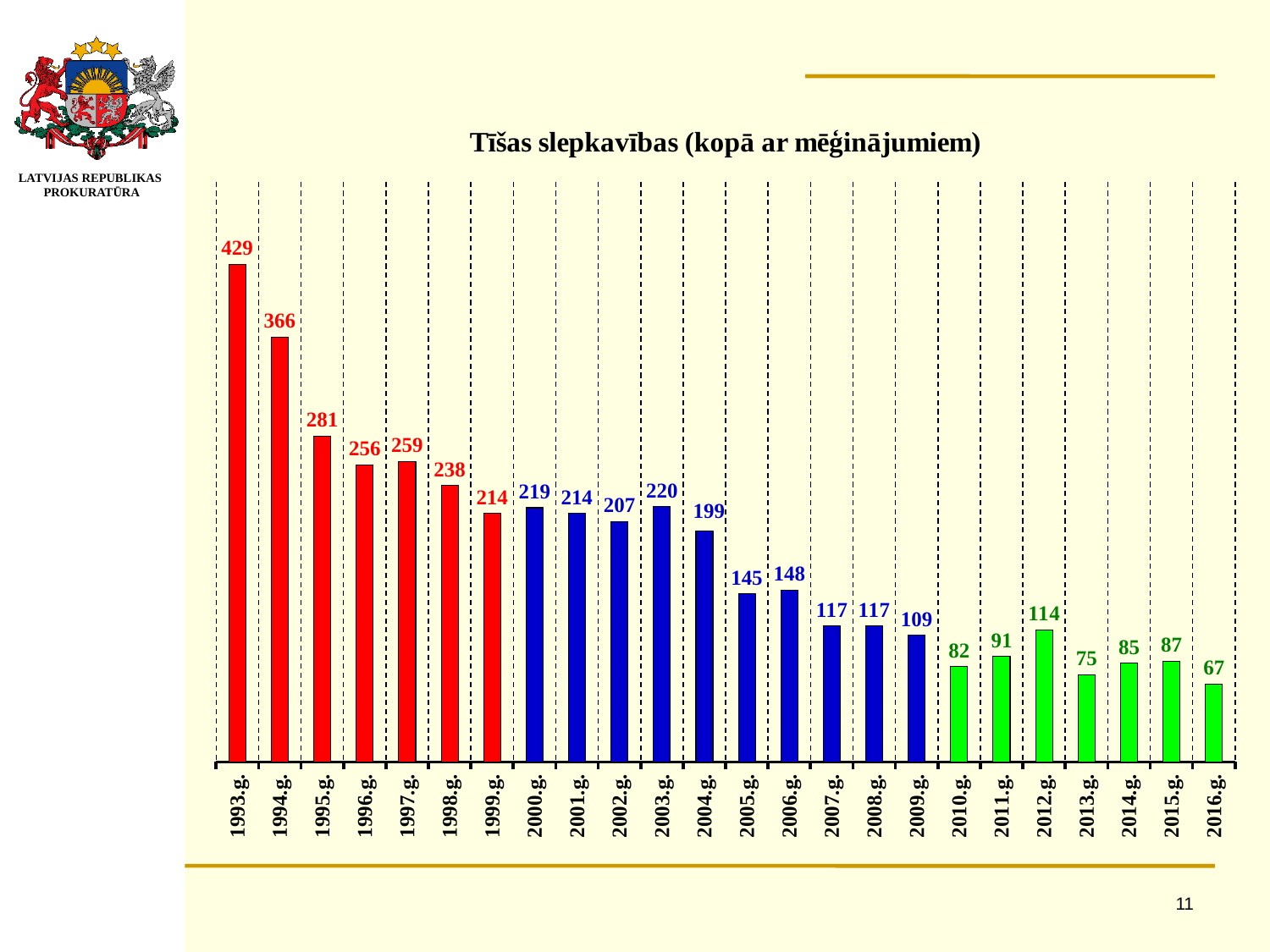
What is the value for 2003.g.? 220 What is the value for 2016.g.? 67 Do the values generally rise or fall from 1993.g. to 2016.g.? fall What is the difference between the values for 1993.g. and 1994.g.? 63 Which year has the highest value? 1993.g. What is the value for 2012.g.? 114 What is the value for 1993.g.? 429 How many years are shown on the x axis? 24 What is the difference between the values for 2009.g. and 2010.g.? 27 Which year has the lowest value? 2016.g. What kind of chart is this? bar chart Which is larger, the value for 2005.g. or the value for 2006.g.? 2006.g.